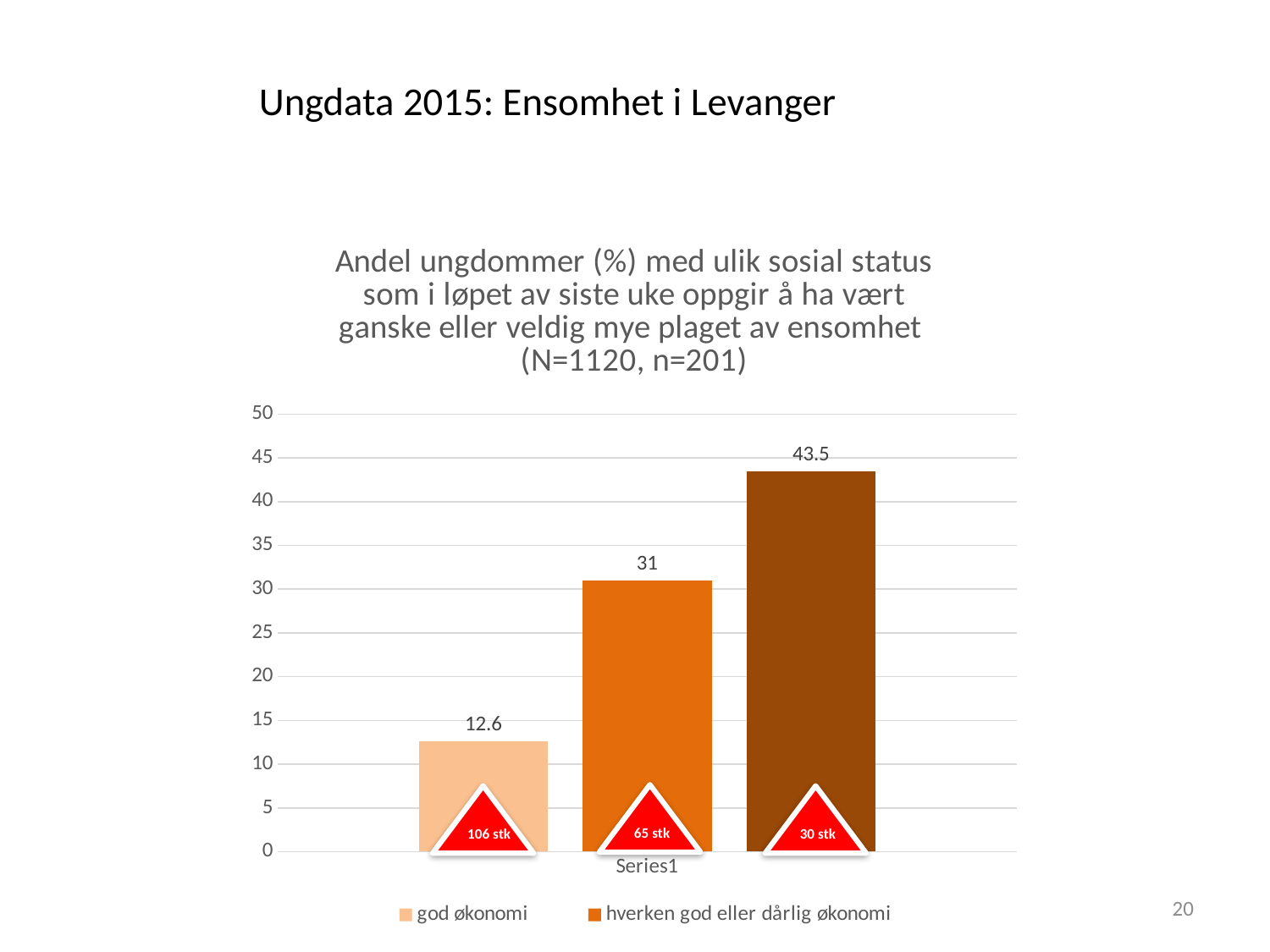
What kind of chart is shown on the slide? bar chart What is the highest value shown on the chart? 43.5 How many entries does the legend list? 2 What is the value for "hverken god eller dårlig økonomi"? 31 Which legend category has the lowest value? god økonomi Which is larger, the value for "god økonomi" or for "hverken god eller dårlig økonomi"? hverken god eller dårlig økonomi What value is labelled on the tallest (dark brown, rightmost) bar? 43.5 What count is written in the red triangle on the "god økonomi" bar? 106 stk What is the difference between the tallest bar (43.5) and the "hverken god eller dårlig økonomi" bar? 12.5 What is the value for "god økonomi"? 12.6 How many bars are plotted on the chart? 3 What is the difference between the values for "hverken god eller dårlig økonomi" and "god økonomi"? 18.4